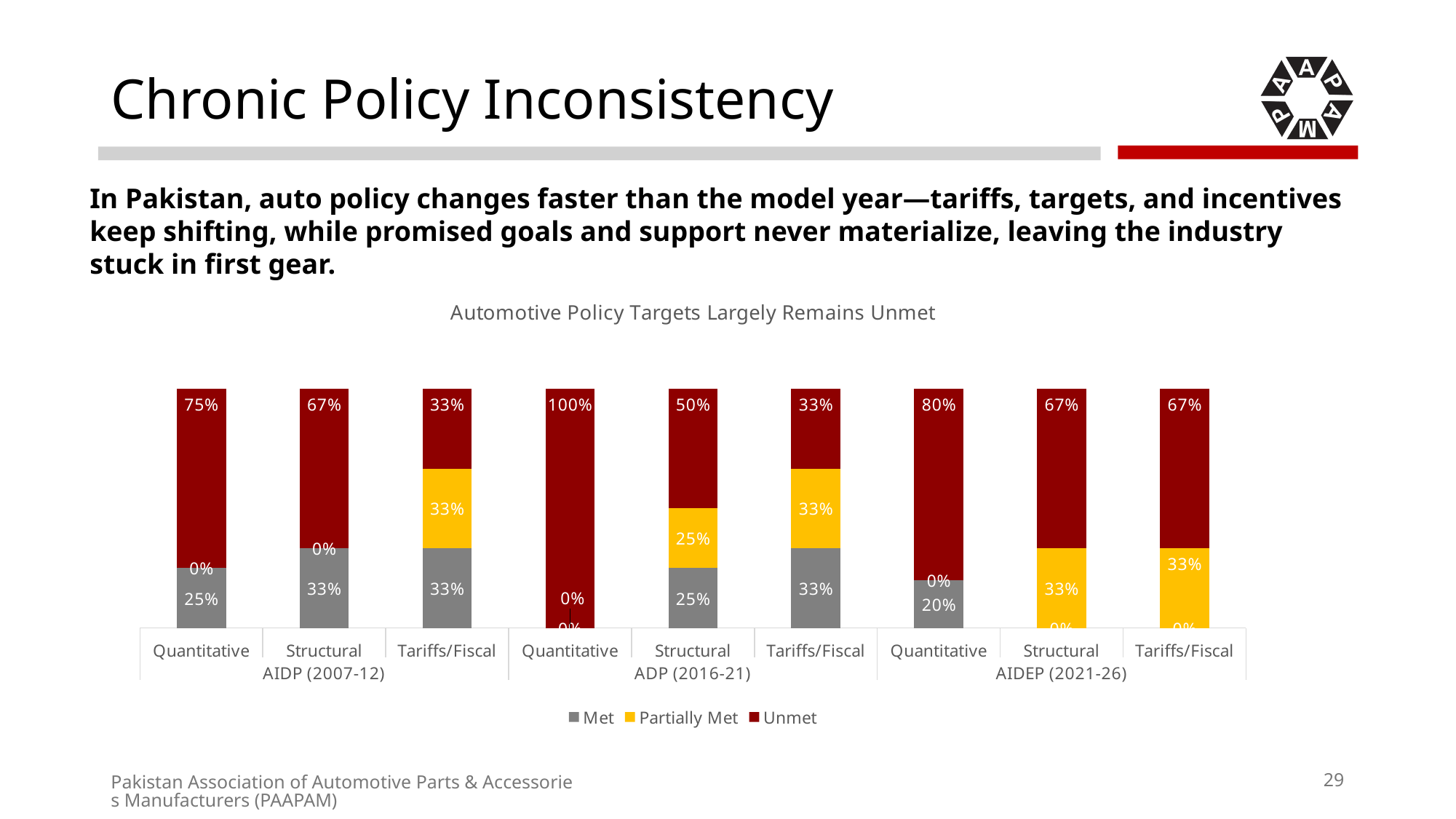
What is the Met share for Structural targets under ADP (2016-21)? 25% Which bar has the highest Unmet share? Quantitative under ADP (2016-21) How many series does the legend list? 3 What is the Unmet share for Quantitative targets under AIDP (2007-12)? 75% Which is larger: the Unmet share for Structural targets under ADP (2016-21) or the Unmet share for Structural targets under AIDEP (2021-26)? Structural under AIDEP (2021-26) How many stacked bars are shown in the chart? 9 What is the title of the chart? Automotive Policy Targets Largely Remains Unmet What is the Partially Met share for Tariffs/Fiscal targets under AIDEP (2021-26)? 33% What is the Met share for Quantitative targets under AIDEP (2021-26)? 20% What kind of chart is shown on the slide? Stacked bar chart Which series is shown in dark red in the chart? Unmet What is the difference between the Unmet share for Quantitative targets under AIDEP (2021-26) and the Unmet share for Quantitative targets under AIDP (2007-12)? 5%